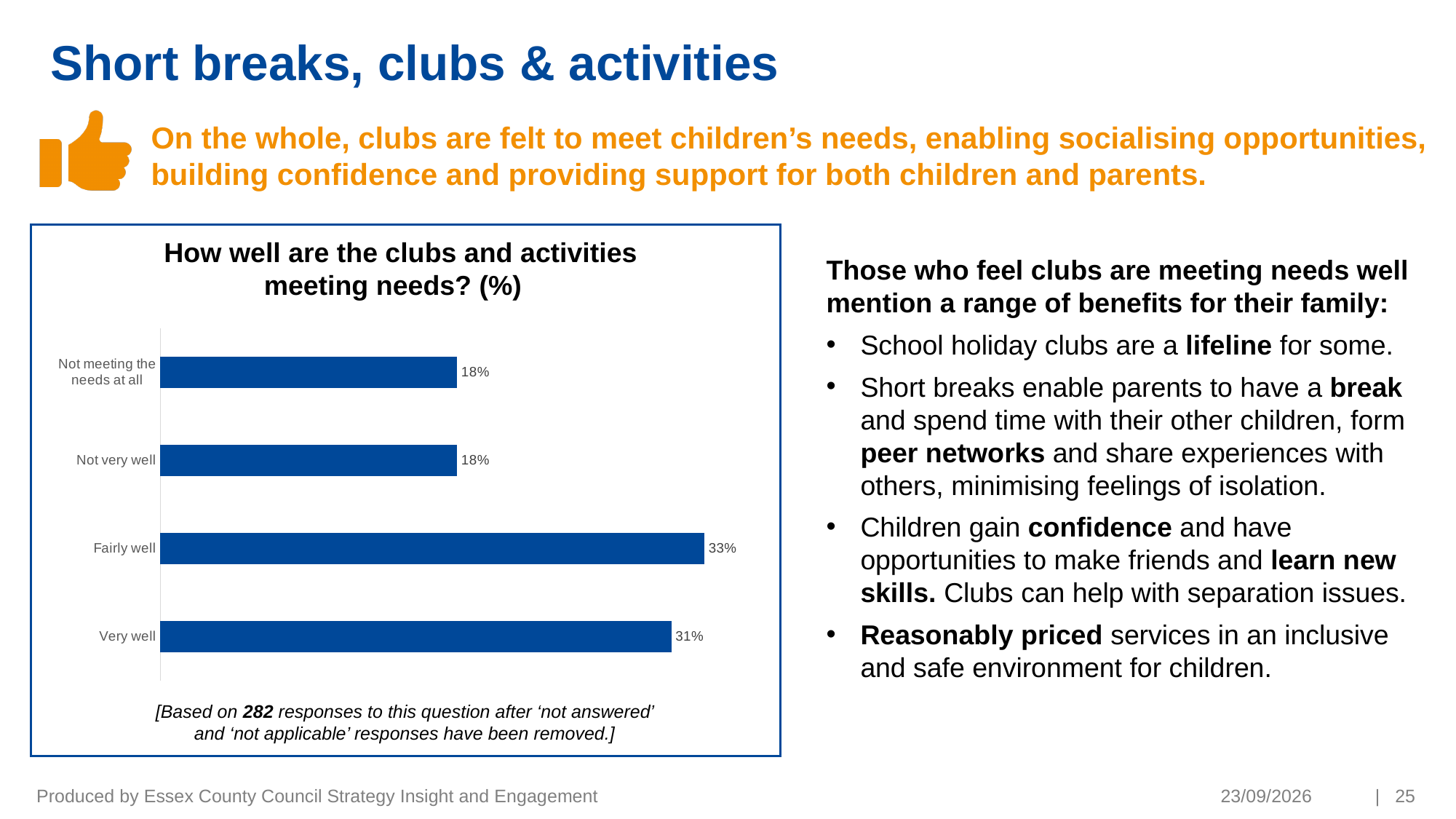
What is the combined percentage for 'Very well' and 'Fairly well'? 64% What is the difference in percentage points between 'Fairly well' and 'Very well'? 2 How many responses is the chart based on, according to the note below it? 282 What percentage of respondents said the clubs and activities are meeting needs 'Fairly well'? 33% How many categories are shown in the chart? 4 Which is larger, the value for 'Very well' or the value for 'Not very well'? Very well What percentage of respondents said the clubs and activities are 'Not meeting the needs at all'? 18% What is the difference in percentage points between 'Fairly well' and 'Not very well'? 15 Which category has the highest percentage in the chart? Fairly well What percentage of respondents said the clubs and activities are meeting needs 'Very well'? 31% What is the title of the chart? How well are the clubs and activities meeting needs? (%) What kind of chart is shown on the slide? Bar chart